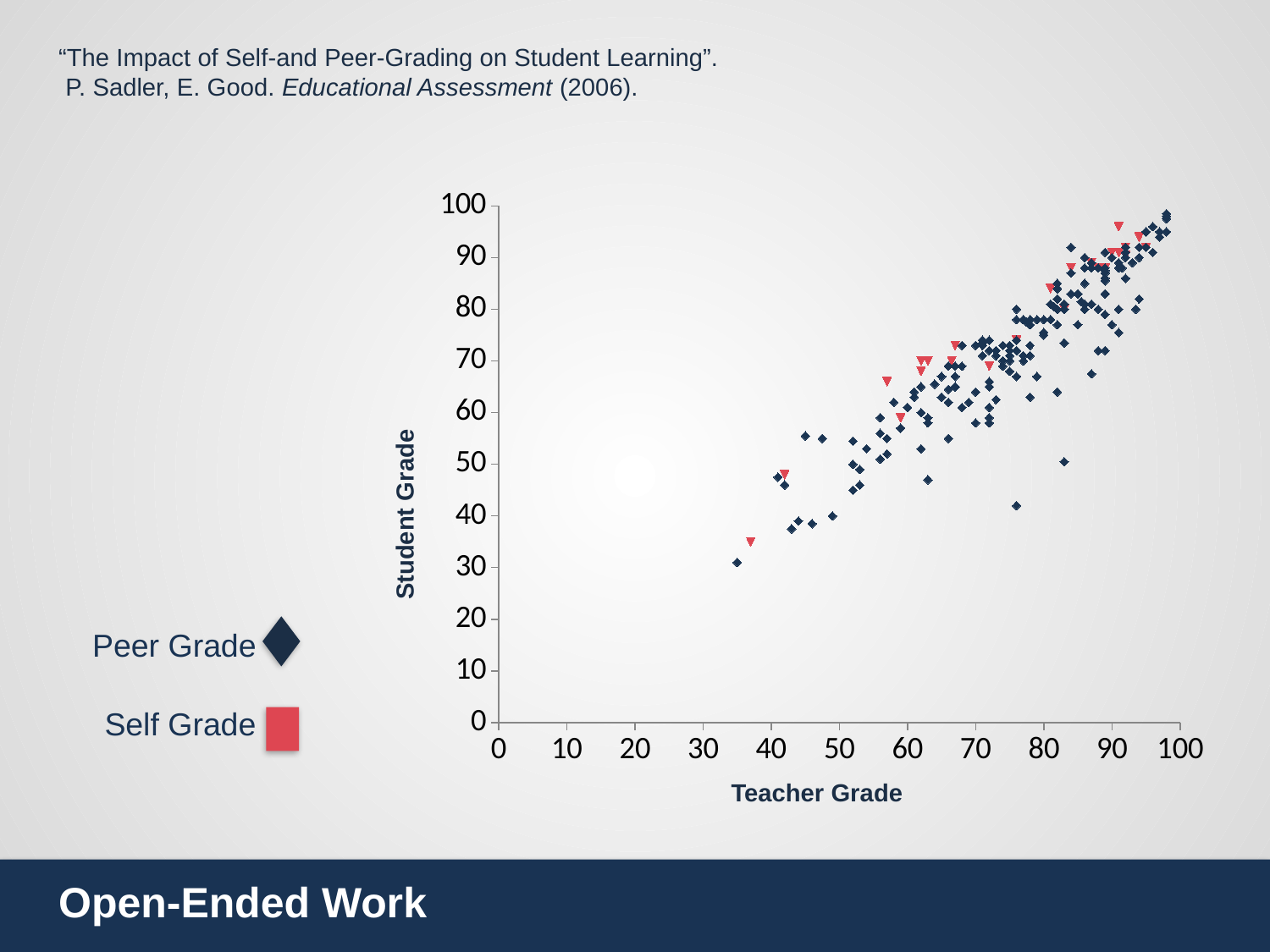
How many series does the legend list? 2 What is the interval between consecutive tick labels on the Teacher Grade axis? 10 Is the Student Grade of the lowest plotted point greater or less than 40? less Is the highest Student Grade plotted greater or less than 90? greater What is the maximum value shown on the Student Grade axis? 100 As Teacher Grade increases along the x axis, do the Student Grade values generally rise or fall? Rise Is the highest Teacher Grade plotted greater or less than 90? greater What kind of chart is shown on the slide? Scatter plot What is the label of the horizontal axis? Teacher Grade What are the two series named in the legend? Peer Grade and Self Grade